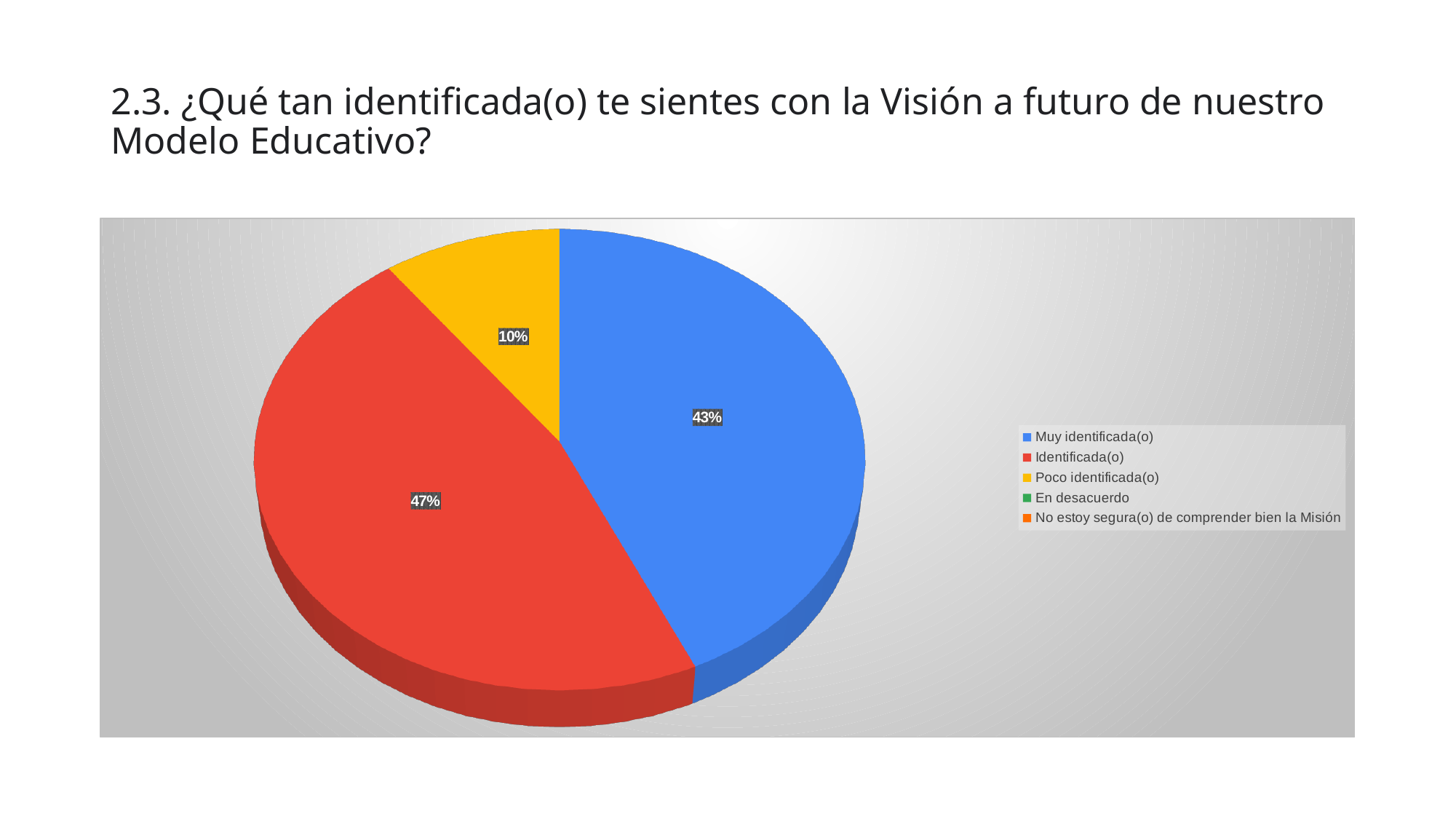
What is the combined share of "Muy identificada(o)" and "Identificada(o)"? 90% Which is larger: the slice for "Muy identificada(o)" or the slice for "Poco identificada(o)"? Muy identificada(o) Which category has the largest slice of the pie? Identificada(o) What share of the pie does "Poco identificada(o)" represent? 10% What kind of chart is shown on the slide? Pie chart How many slices with a visible percentage label does the pie have? 3 What share of the pie does "Identificada(o)" represent? 47% Which of the three labelled slices is the smallest? Poco identificada(o) What is the difference in percentage points between "Identificada(o)" and "Muy identificada(o)"? 4 How many entries does the legend list? 5 What share of the pie does "Muy identificada(o)" represent? 43% What colour is the slice for "Identificada(o)"? Red